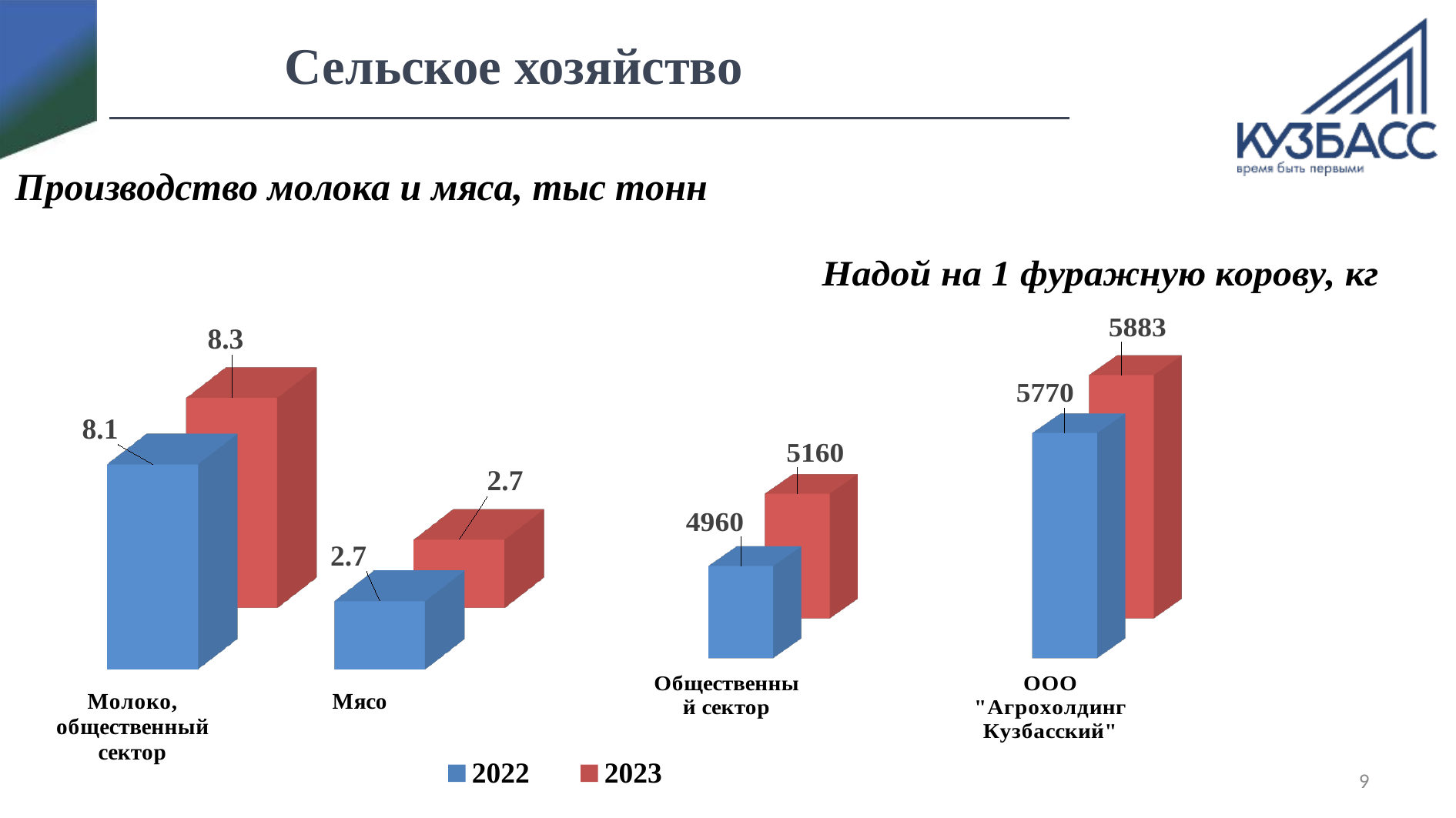
In the chart 'Производство молока и мяса, тыс тонн', which category has the highest 2022 value? Молоко, общественный сектор Which colour represents 2023 in the legend? Red In the chart 'Надой на 1 фуражную корову, кг', what is the 2023 value for ООО "Агрохолдинг Кузбасский"? 5883 In the chart 'Производство молока и мяса, тыс тонн', what is the difference between the 2023 and 2022 values for 'Молоко, общественный сектор'? 0.2 In the chart 'Надой на 1 фуражную корову, кг', what is the 2022 value for 'Общественный сектор'? 4960 In the chart 'Надой на 1 фуражную корову, кг', which is larger: the 2022 value for ООО "Агрохолдинг Кузбасский" or the 2023 value for 'Общественный сектор'? 2022 value for ООО "Агрохолдинг Кузбасский" In the chart 'Производство молока и мяса, тыс тонн', what is the 2022 value for 'Мясо'? 2.7 What kind of chart is 'Надой на 1 фуражную корову, кг'? Bar chart In the chart 'Надой на 1 фуражную корову, кг', which category has the lowest 2023 value? Общественный сектор In the chart 'Надой на 1 фуражную корову, кг', what is the difference between the 2023 and 2022 values for 'Общественный сектор'? 200 How many series does the legend at the bottom of the slide list? 2 In the chart 'Производство молока и мяса, тыс тонн', what is the 2023 value for 'Молоко, общественный сектор'? 8.3